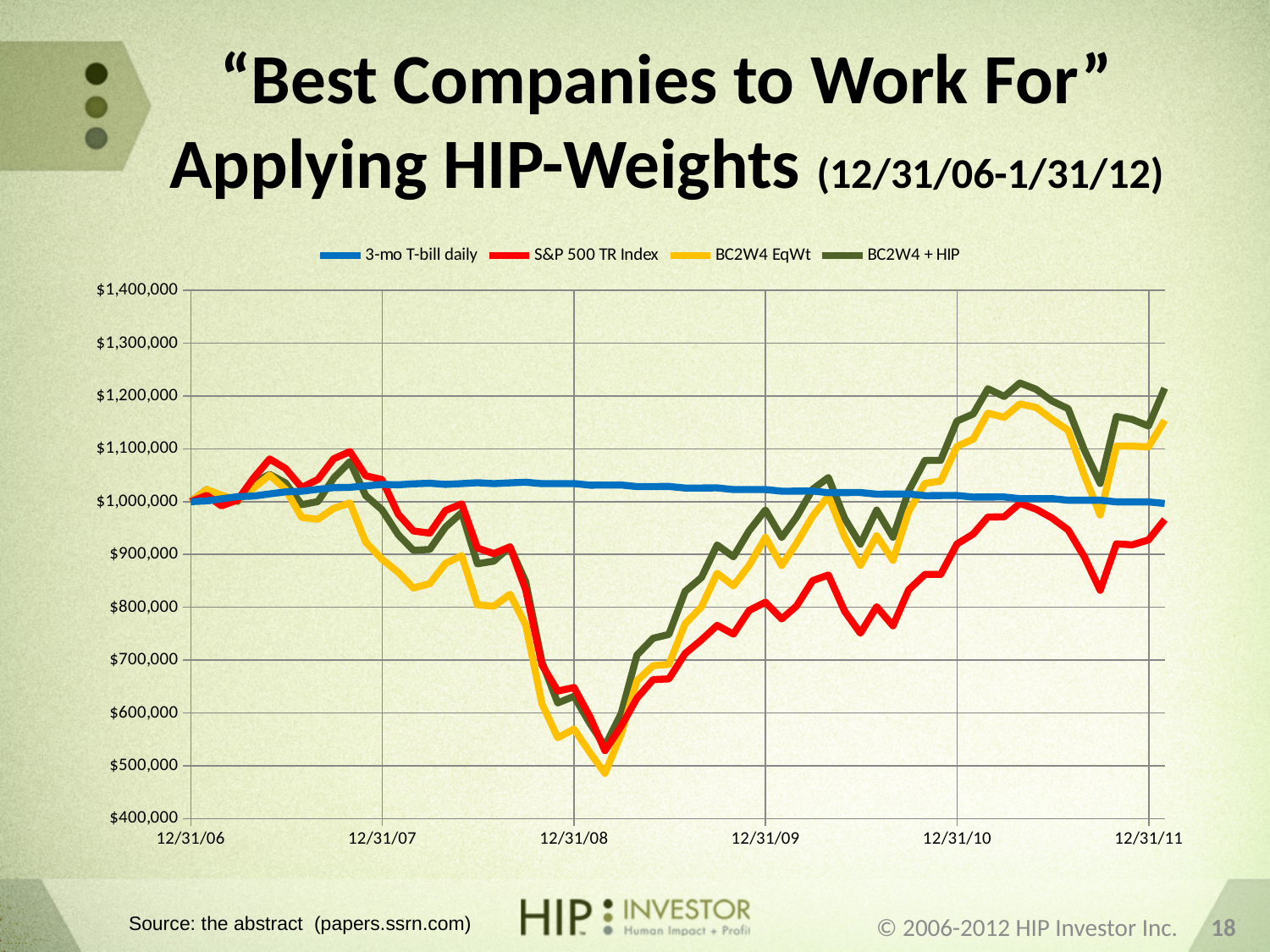
Does the S&P 500 TR Index rise or fall between 12/31/07 and 12/31/08? Fall Does BC2W4 + HIP rise or fall between 12/31/08 and 12/31/10? Rise Is the value of BC2W4 + HIP at 12/31/11 greater or less than $1,100,000? greater Which series reaches the lowest point on the chart? BC2W4 EqWt How many date labels are shown along the x axis? 6 What kind of chart is shown on the slide? Line chart At 12/31/11, which is higher: BC2W4 + HIP or the S&P 500 TR Index? BC2W4 + HIP Is the value of the S&P 500 TR Index at 12/31/08 greater or less than $700,000? less Which series ends highest at 12/31/11? BC2W4 + HIP How many series does the legend list? 4 What colour is the S&P 500 TR Index line in the legend? Red Is the value of the S&P 500 TR Index at 12/31/11 greater or less than $1,000,000? less